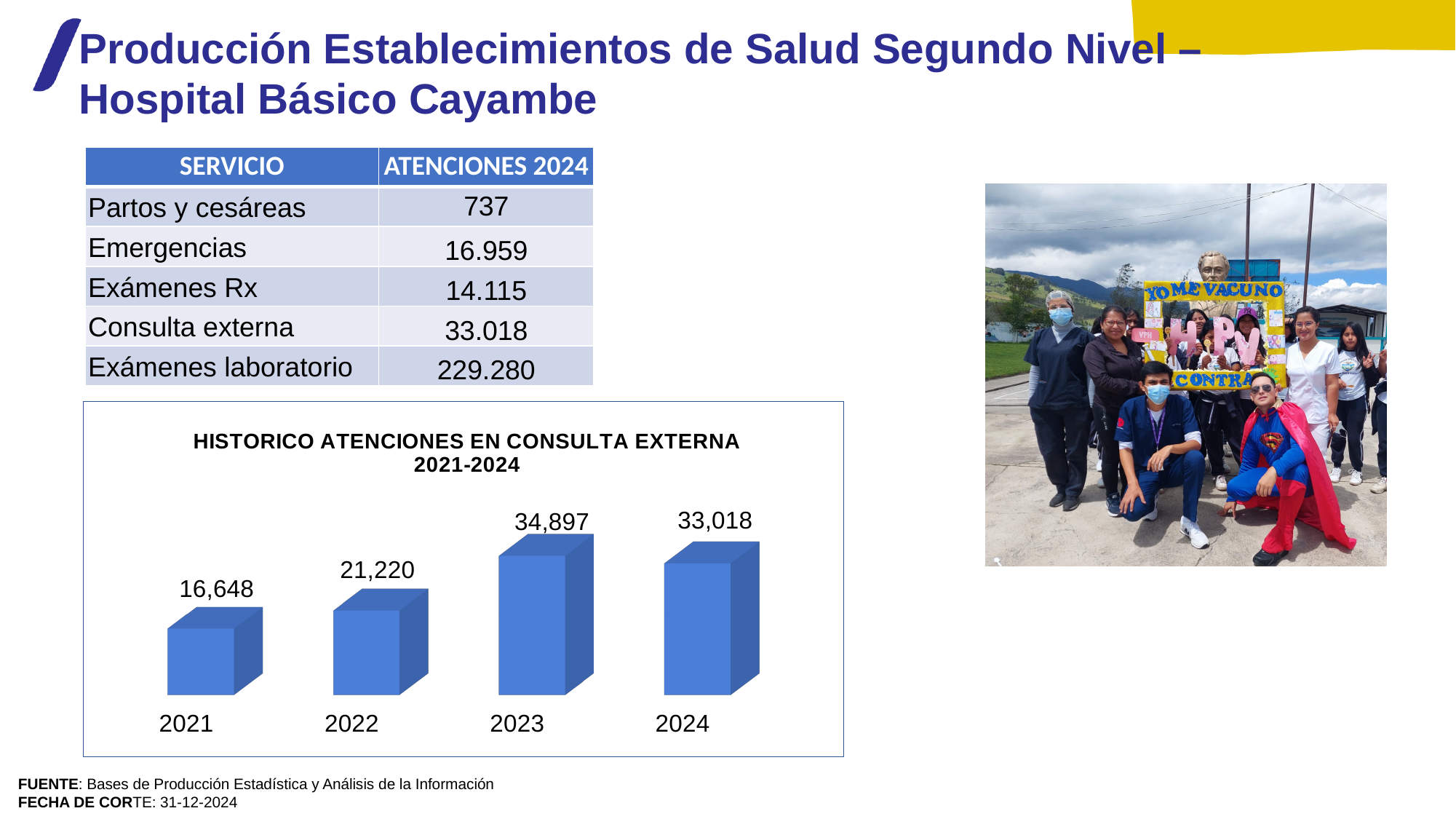
What is the value for 2021 in the chart? 16,648 Which year has the highest value in the chart? 2023 What is the difference between the values for 2023 and 2024? 1,879 Which is larger, the value for 2022 or the value for 2024? 2024 What is the difference between the values for 2022 and 2021? 4,572 Do the values rise or fall from 2021 to 2023? Rise How many years are shown in the chart? 4 What is the title of the chart? HISTORICO ATENCIONES EN CONSULTA EXTERNA 2021-2024 What is the value for 2024 in the chart? 33,018 What is the value for 2023 in the chart? 34,897 What kind of chart is shown on the slide? Bar chart Which year has the lowest value in the chart? 2021